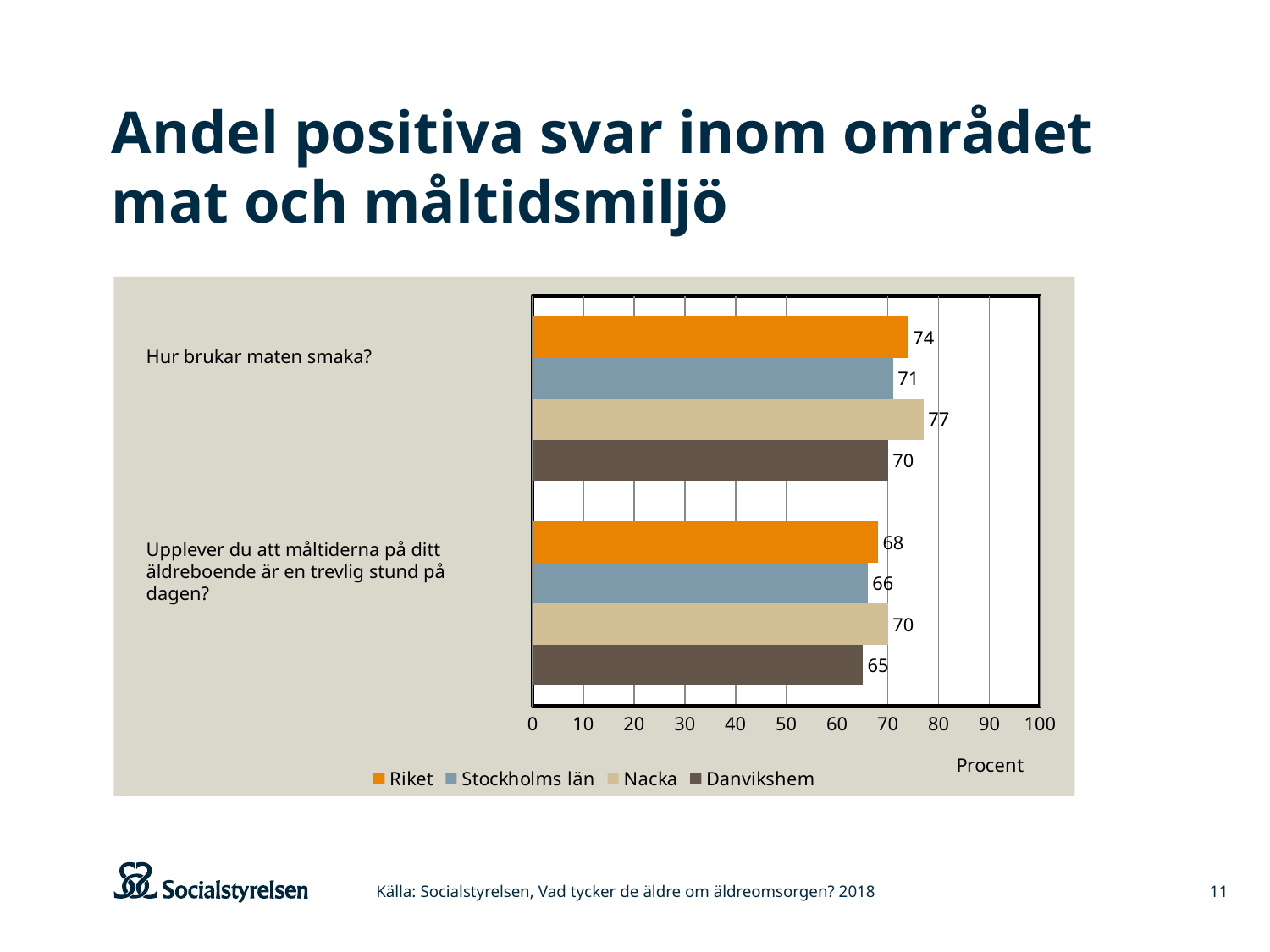
What is the value for Nacka on the question "Hur brukar maten smaka?"? 77 What is the difference between the Nacka and Danvikshem values on the question "Hur brukar maten smaka?"? 7 Which series has the lowest value on the question "Upplever du att måltiderna på ditt äldreboende är en trevlig stund på dagen?"? Danvikshem What is the label of the horizontal axis? Procent How many series does the legend list? 4 What is the value for Riket on the question "Hur brukar maten smaka?"? 74 Is the value for Danvikshem on "Hur brukar maten smaka?" greater or less than 80? less Which is larger on the question "Upplever du att måltiderna på ditt äldreboende är en trevlig stund på dagen?": Riket or Stockholms län? Riket What is the value for Stockholms län on the question "Upplever du att måltiderna på ditt äldreboende är en trevlig stund på dagen?"? 66 What is the value for Danvikshem on the question "Upplever du att måltiderna på ditt äldreboende är en trevlig stund på dagen?"? 65 What kind of chart is shown on the slide? Bar chart Which series has the highest value on the question "Hur brukar maten smaka?"? Nacka